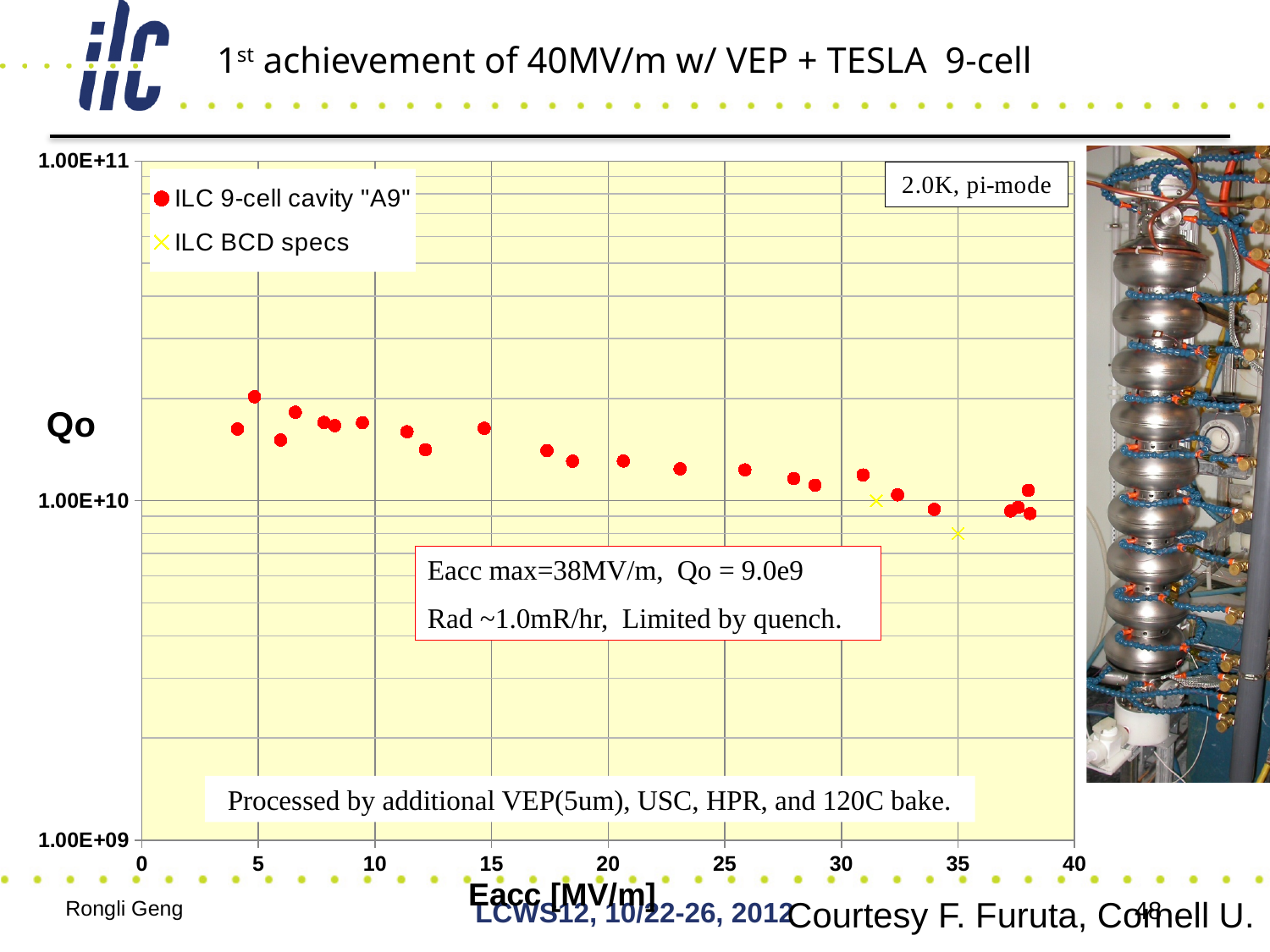
Is the Qo value for the ILC 9-cell cavity "A9" at Eacc of about 5 MV/m greater or less than 1.00E+10? greater What are the two series named in the chart legend? ILC 9-cell cavity "A9" and ILC BCD specs What is the highest value shown on the x axis of the chart? 40 According to the annotation on the chart, what is the maximum Eacc reached? 38MV/m How many ILC BCD specs points are plotted on the chart? 2 According to the annotation on the chart, what is Qo at the maximum Eacc? 9.0e9 How many series does the chart legend list? 2 What is the label of the x axis of the chart? Eacc [MV/m] As Eacc increases along the x axis, does Qo for the ILC 9-cell cavity "A9" generally rise or fall? fall Is the Qo value for the ILC 9-cell cavity "A9" at Eacc of about 15 MV/m greater or less than 1.00E+10? greater What kind of chart is shown on the slide? scatter chart Is the Qo value of the ILC BCD specs point at Eacc of about 35 MV/m greater or less than 1.00E+10? less